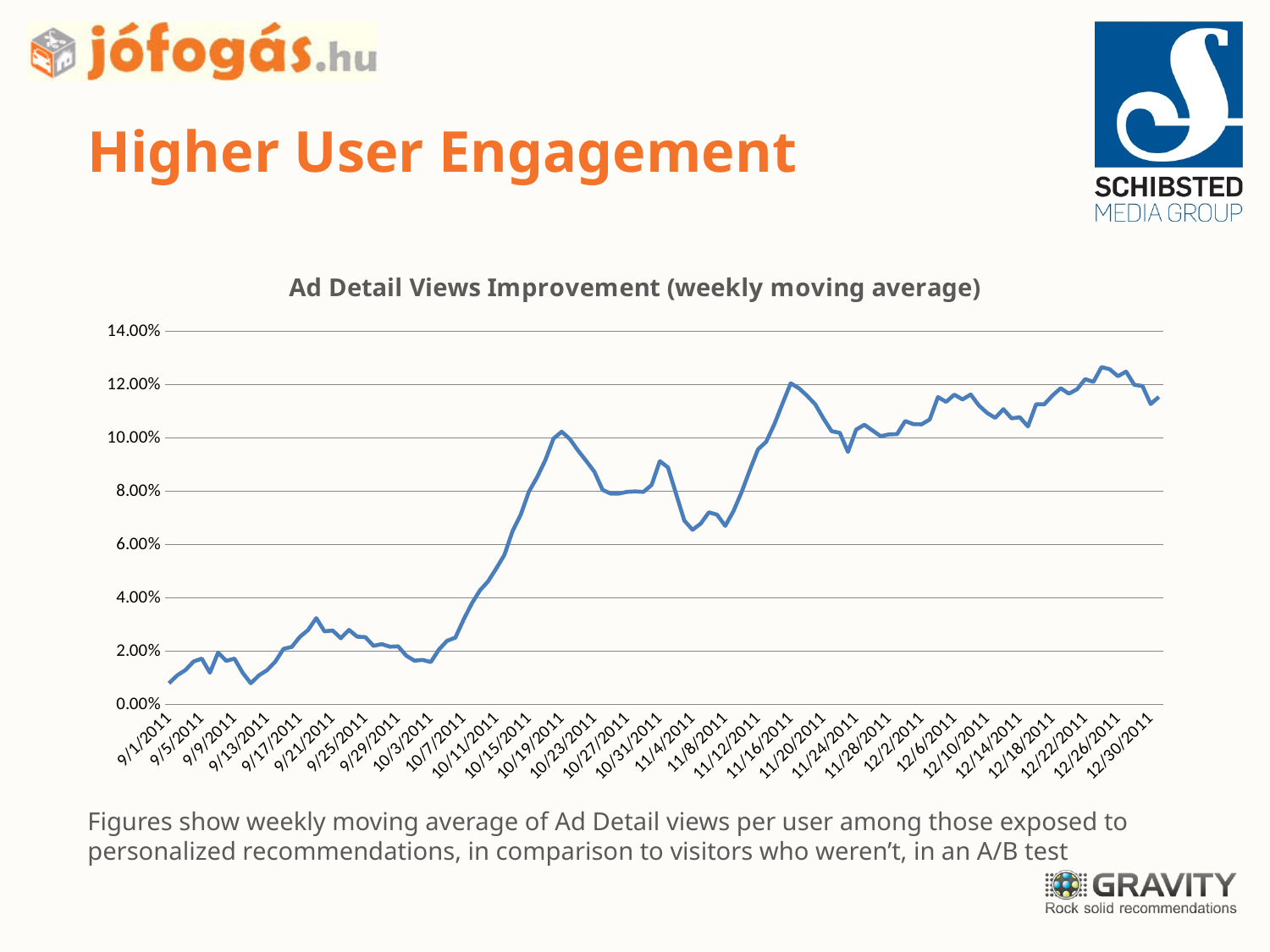
Which has the larger value, 11/16/2011 or 11/4/2011? 11/16/2011 Which has the larger value, 10/19/2011 or 10/27/2011? 10/19/2011 Is the value for 12/30/2011 greater or less than 10.00%? greater Is the value for 10/3/2011 greater or less than 4.00%? less What is the title of the chart? Ad Detail Views Improvement (weekly moving average) What kind of chart is shown on the slide? line chart What is the highest value shown on the y axis? 14.00% Is the value for 10/19/2011 greater or less than 8.00%? greater Overall, do the values rise or fall from 9/1/2011 to 12/30/2011? rise